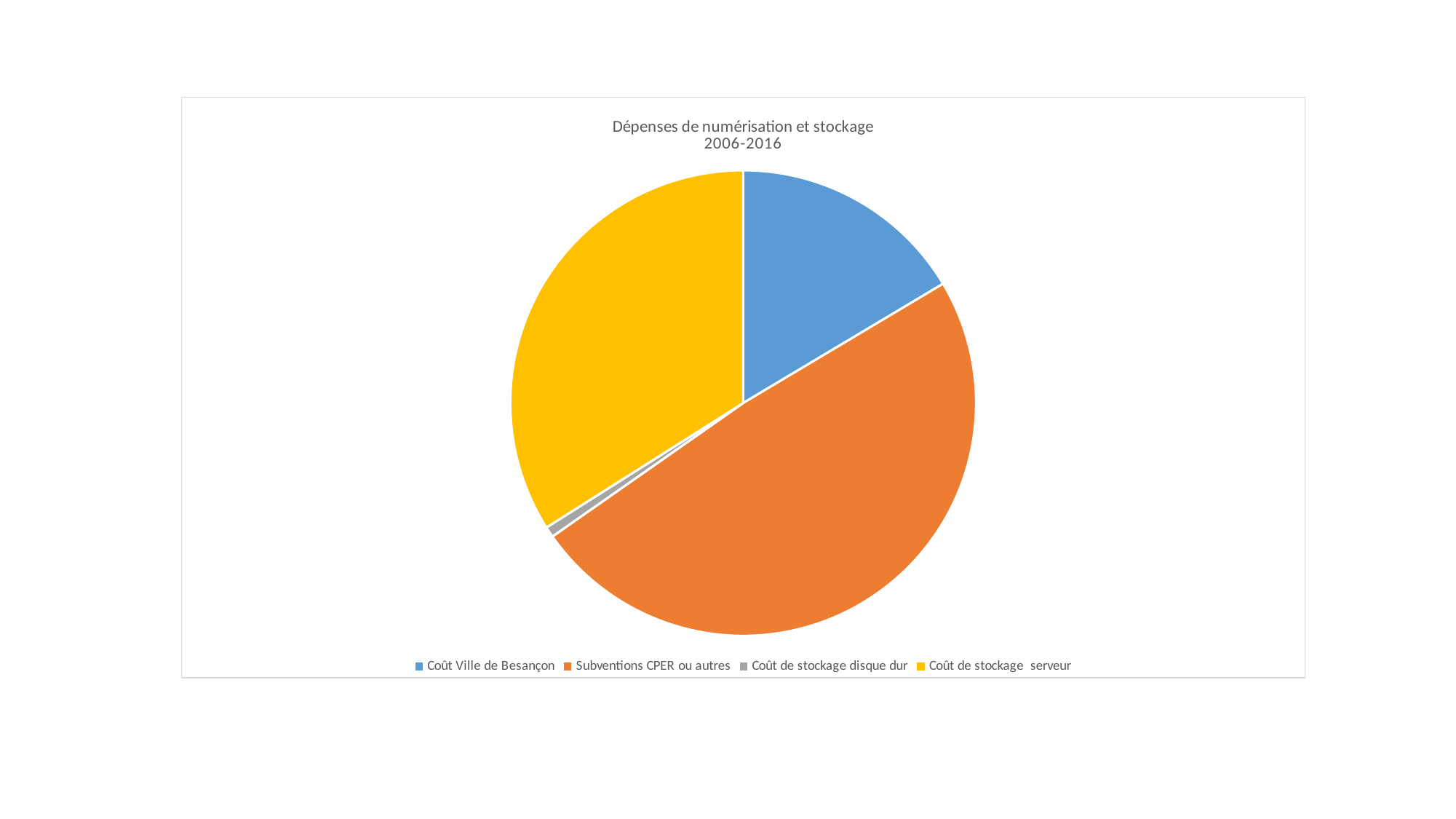
Which is larger, the slice for Coût Ville de Besançon or the slice for Coût de stockage disque dur? Coût Ville de Besançon Which category has the smallest slice of the pie? Coût de stockage disque dur Which is larger, the slice for Coût Ville de Besançon or the slice for Coût de stockage serveur? Coût de stockage serveur Which is larger, the slice for Subventions CPER ou autres or the slice for Coût de stockage serveur? Subventions CPER ou autres Which category has the largest slice of the pie? Subventions CPER ou autres How many entries does the legend list? 4 How many slices does the pie chart have? 4 What kind of chart is shown on the slide? pie chart What is the title of the chart? Dépenses de numérisation et stockage 2006-2016 Which colour represents Coût de stockage serveur in the pie chart? yellow